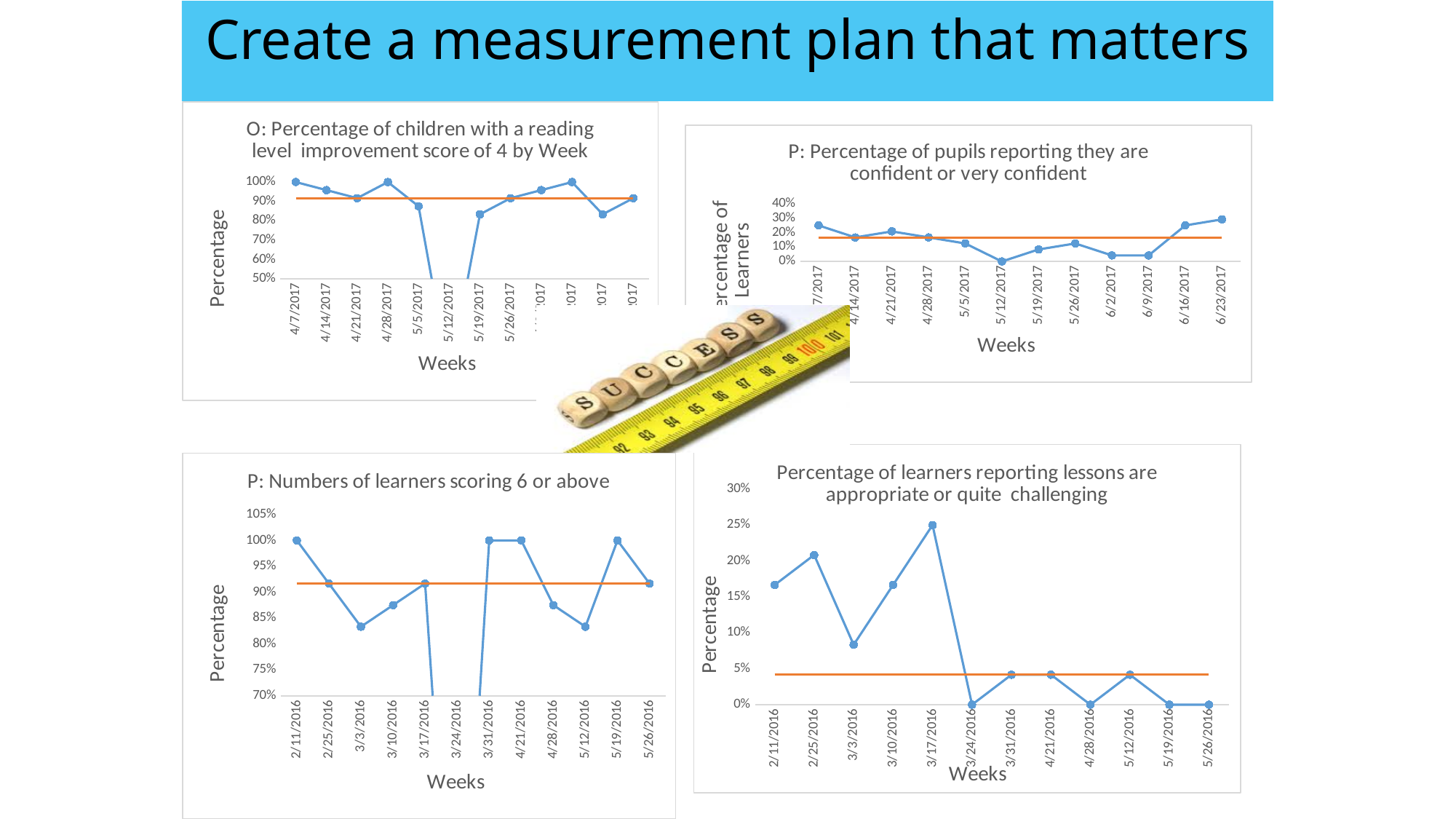
In the chart titled 'O: Percentage of children with a reading level improvement score of 4 by Week', what is the value for 4/28/2017? 100% In the chart titled 'Percentage of learners reporting lessons are appropriate or quite challenging', which week has the highest value? 3/17/2016 How many charts are shown on the slide? 4 In the chart titled 'Percentage of learners reporting lessons are appropriate or quite challenging', what kind of chart is shown? line chart In the chart titled 'P: Numbers of learners scoring 6 or above', how many weeks are plotted on the x axis? 12 In the chart titled 'P: Percentage of pupils reporting they are confident or very confident', what is the value for 5/12/2017? 0% In the chart titled 'O: Percentage of children with a reading level improvement score of 4 by Week', is the value for 5/19/2017 greater or less than 90%? less In the chart titled 'P: Percentage of pupils reporting they are confident or very confident', which week has the highest value? 6/23/2017 In the chart titled 'P: Percentage of pupils reporting they are confident or very confident', is the value for 4/7/2017 greater or less than 20%? greater In the chart titled 'Percentage of learners reporting lessons are appropriate or quite challenging', which is larger: the value for 2/25/2016 or the value for 3/3/2016? 2/25/2016 In the chart titled 'Percentage of learners reporting lessons are appropriate or quite challenging', what is the value for 3/17/2016? 25% In the chart titled 'P: Numbers of learners scoring 6 or above', what is the value for 2/11/2016? 100%